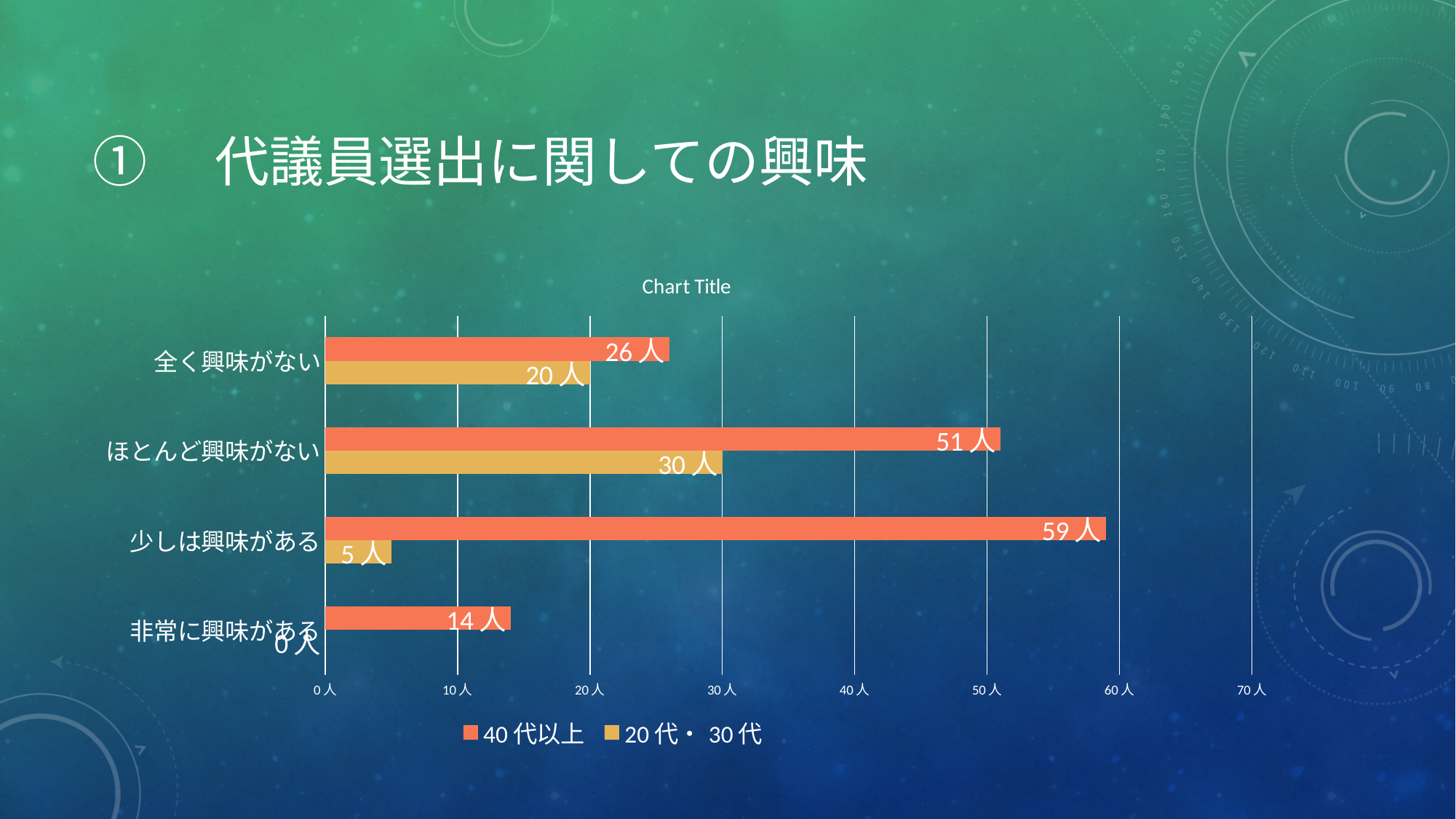
What is the total of the 40 代以上 and 20 代・30 代 values in the 全く興味がない category? 46 人 What colour represents the 20 代・30 代 series? yellow How many series does the legend list? 2 How many categories are shown on the vertical axis? 4 What is the value for 20 代・30 代 in the 非常に興味がある category? 0 人 Which category has the highest value for 40 代以上? 少しは興味がある What type of chart is shown on the slide? bar chart What is the difference between the 40 代以上 and 20 代・30 代 values in the ほとんど興味がない category? 21 人 What is the value for 20 代・30 代 in the ほとんど興味がない category? 30 人 Which is larger in the 全く興味がない category: 40 代以上 or 20 代・30 代? 40 代以上 Which category has the lowest value for 20 代・30 代? 非常に興味がある What is the value for 40 代以上 in the 少しは興味がある category? 59 人